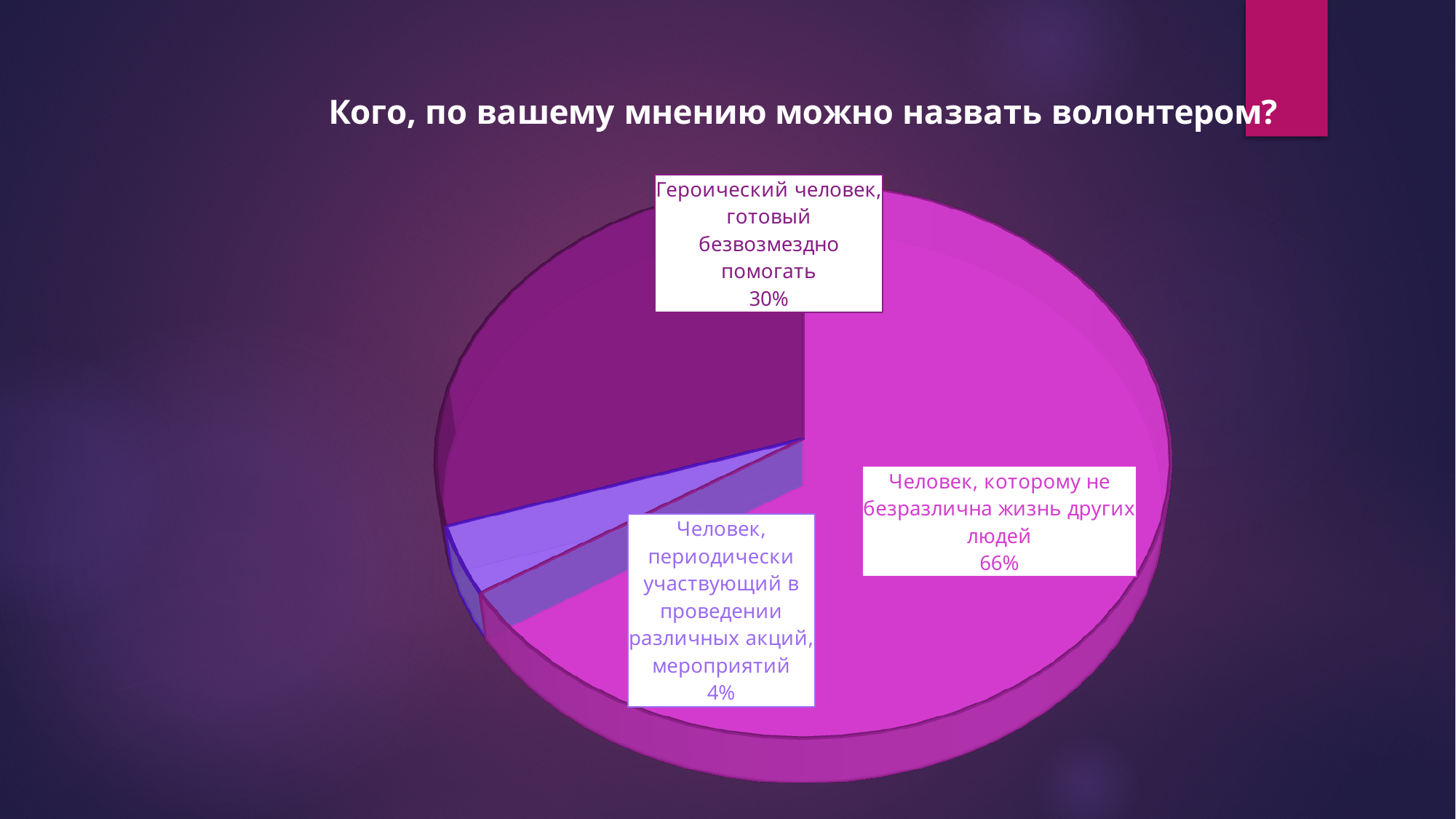
What is the combined share of the two smaller slices (30% and 4%)? 34% Which is larger: the share for "Героический человек, готовый безвозмездно помогать" or the share for "Человек, периодически участвующий в проведении различных акций, мероприятий"? Героический человек, готовый безвозмездно помогать Which category has the smallest share of the pie? Человек, периодически участвующий в проведении различных акций, мероприятий What share of the pie is labelled "Героический человек, готовый безвозмездно помогать"? 30% How many slices does the pie chart have? 3 What is the difference in percentage points between the "Человек, которому не безразлична жизнь других людей" slice and the "Героический человек, готовый безвозмездно помогать" slice? 36 percentage points Which category has the largest share of the pie? Человек, которому не безразлична жизнь других людей What share of the pie is labelled "Человек, периодически участвующий в проведении различных акций, мероприятий"? 4% What kind of chart is shown on the slide? Pie chart What share of the pie is labelled "Человек, которому не безразлична жизнь других людей"? 66% What is the title of the slide above the chart? Кого, по вашему мнению можно назвать волонтером?